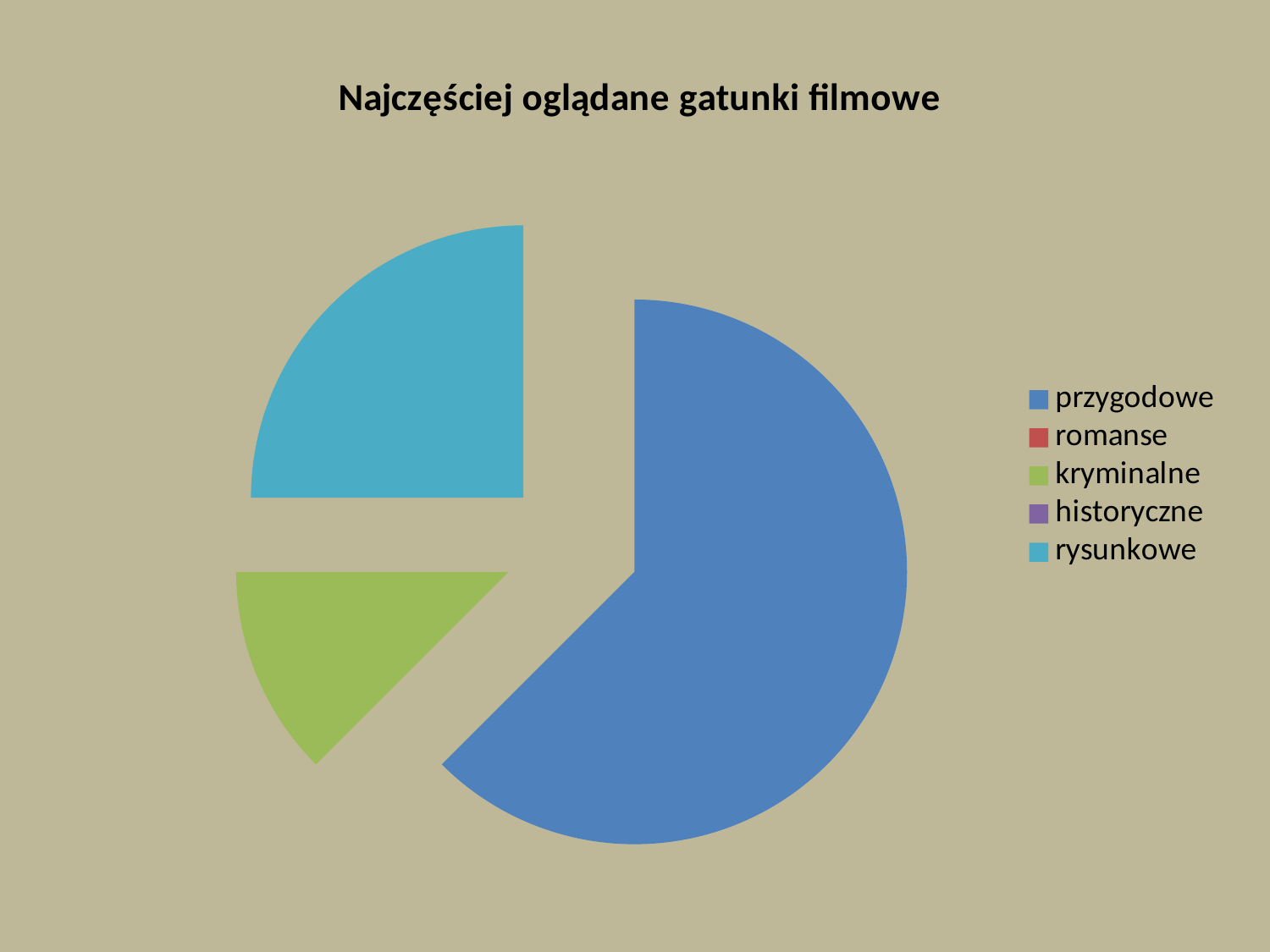
What is the title of the chart? Najczęściej oglądane gatunki filmowe How many slices are visibly drawn in the pie? 3 How many entries does the chart's legend list? 5 Which slice is larger, rysunkowe or kryminalne? rysunkowe Which slice is larger, kryminalne or przygodowe? przygodowe What kind of chart is shown on the slide? pie chart Which category has the largest slice of the pie? przygodowe Which slice is larger, przygodowe or rysunkowe? przygodowe What colour is the slice for przygodowe? blue